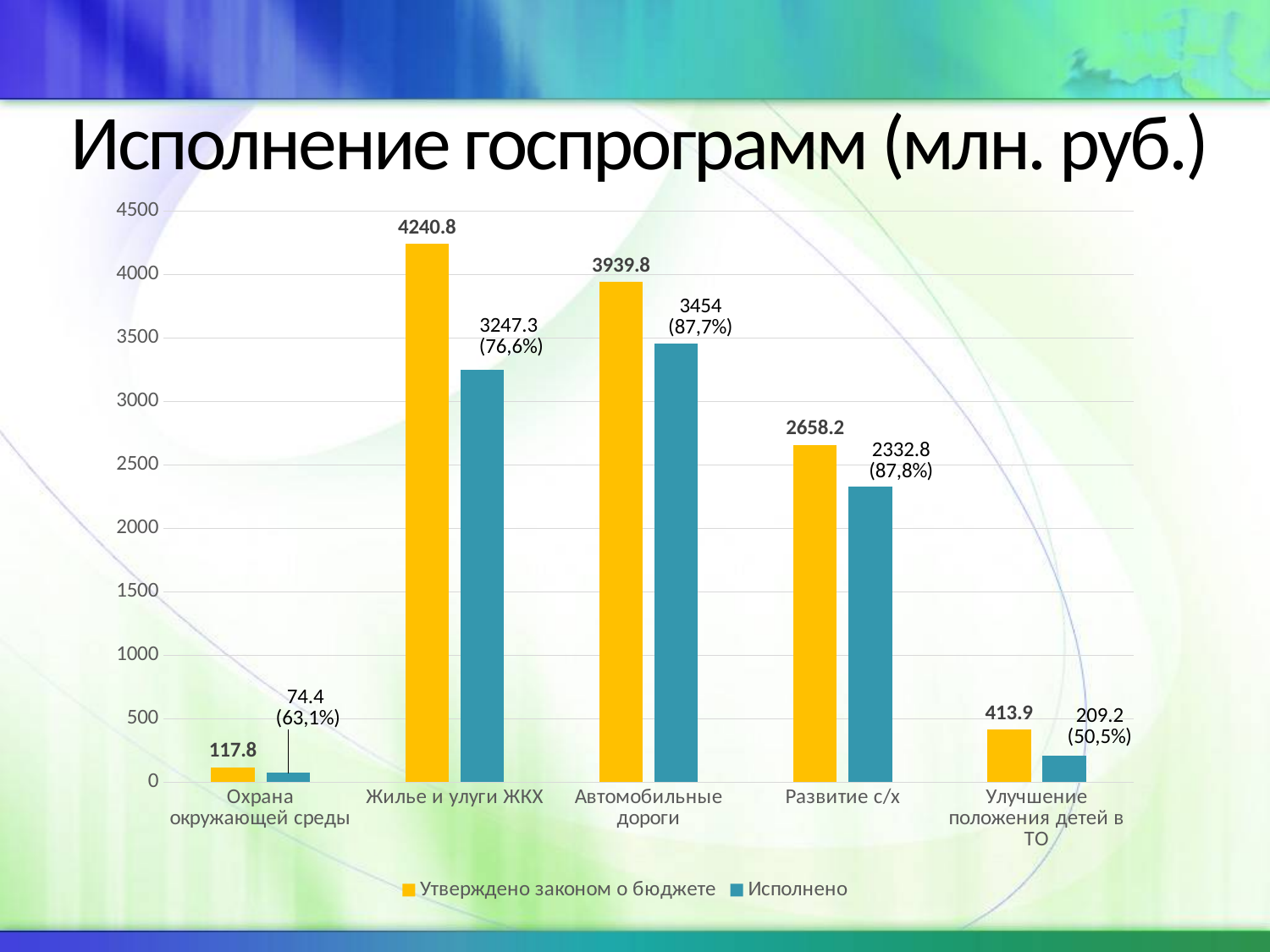
Which category has the highest 'Утверждено законом о бюджете' value? Жилье и улуги ЖКХ What percentage is shown next to the 'Исполнено' value for 'Улучшение положения детей в ТО'? 50,5% What is the value of 'Исполнено' for 'Автомобильные дороги'? 3454 Which is larger: the 'Исполнено' value for 'Автомобильные дороги' or for 'Жилье и улуги ЖКХ'? Автомобильные дороги Which category has the lowest 'Исполнено' value? Охрана окружающей среды What is the difference between 'Утверждено законом о бюджете' and 'Исполнено' for 'Развитие с/х'? 325.4 How many series does the legend list? 2 What is the value of 'Исполнено' for 'Охрана окружающей среды'? 74.4 What is the value of 'Утверждено законом о бюджете' for 'Жилье и улуги ЖКХ'? 4240.8 Is the 'Утверждено законом о бюджете' value for 'Развитие с/х' greater or less than 2500? greater How many categories are shown on the x axis? 5 What type of chart is shown on the slide? bar chart